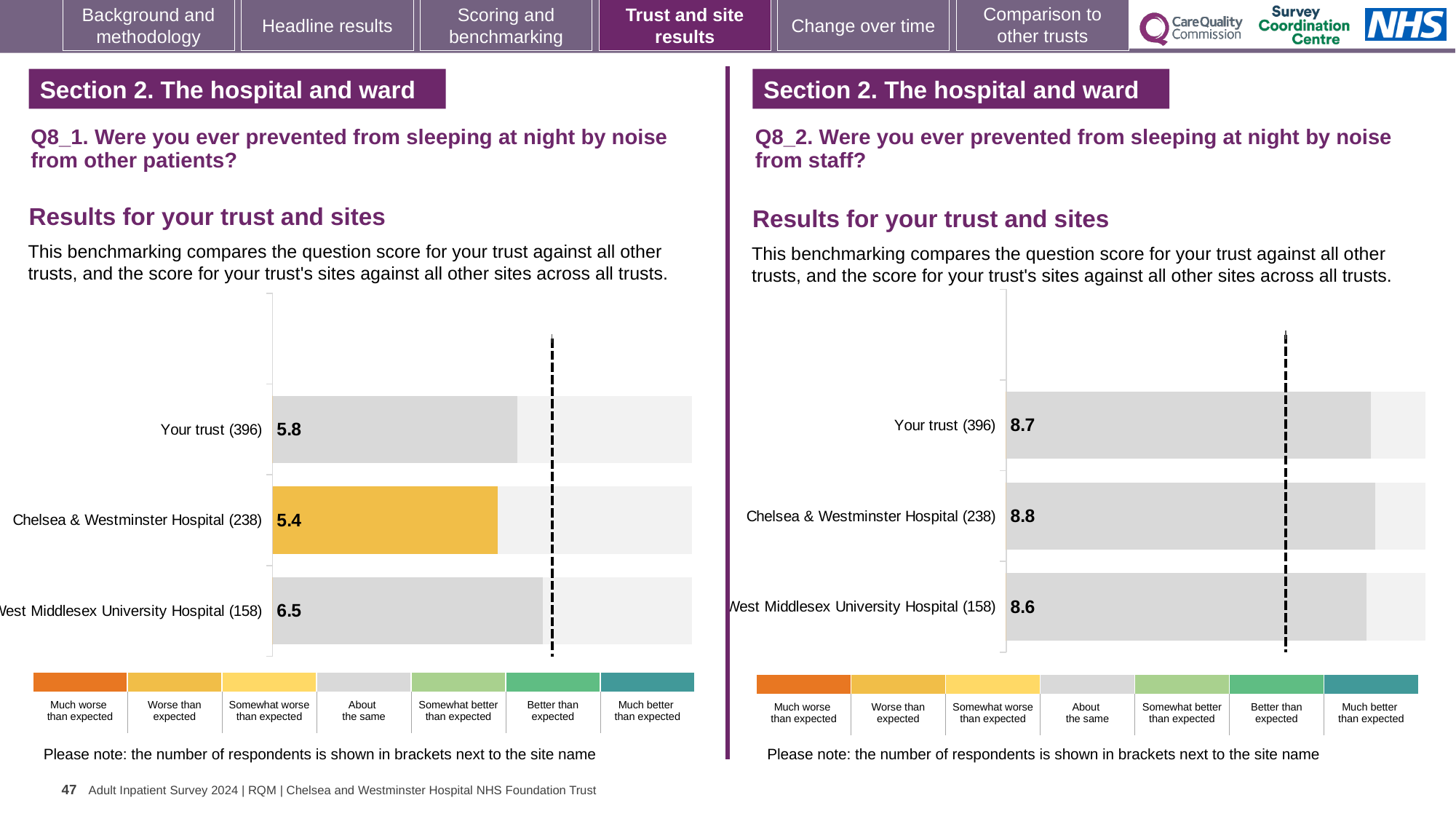
In the Q8_1 chart (noise from other patients), what is the score for West Middlesex University Hospital (158)? 6.5 How many bars are plotted in the Q8_2 chart (noise from staff)? 3 In the Q8_2 chart (noise from staff), what is the difference between the scores for Chelsea & Westminster Hospital (238) and West Middlesex University Hospital (158)? 0.2 In the Q8_1 chart (noise from other patients), what is the score for Chelsea & Westminster Hospital (238)? 5.4 In the Q8_1 chart (noise from other patients), which site or trust has the highest score? West Middlesex University Hospital (158) In the Q8_1 chart (noise from other patients), what is the difference between the scores for West Middlesex University Hospital (158) and Chelsea & Westminster Hospital (238)? 1.1 In the Q8_1 chart (noise from other patients), what is the score for Your trust (396)? 5.8 In the Q8_1 chart (noise from other patients), which site or trust has the lowest score? Chelsea & Westminster Hospital (238) In the Q8_2 chart (noise from staff), what is the score for Your trust (396)? 8.7 In the Q8_2 chart (noise from staff), what is the score for Chelsea & Westminster Hospital (238)? 8.8 What type of chart is used for the Q8_1 results (noise from other patients)? Bar chart In the Q8_2 chart (noise from staff), what is the score for West Middlesex University Hospital (158)? 8.6